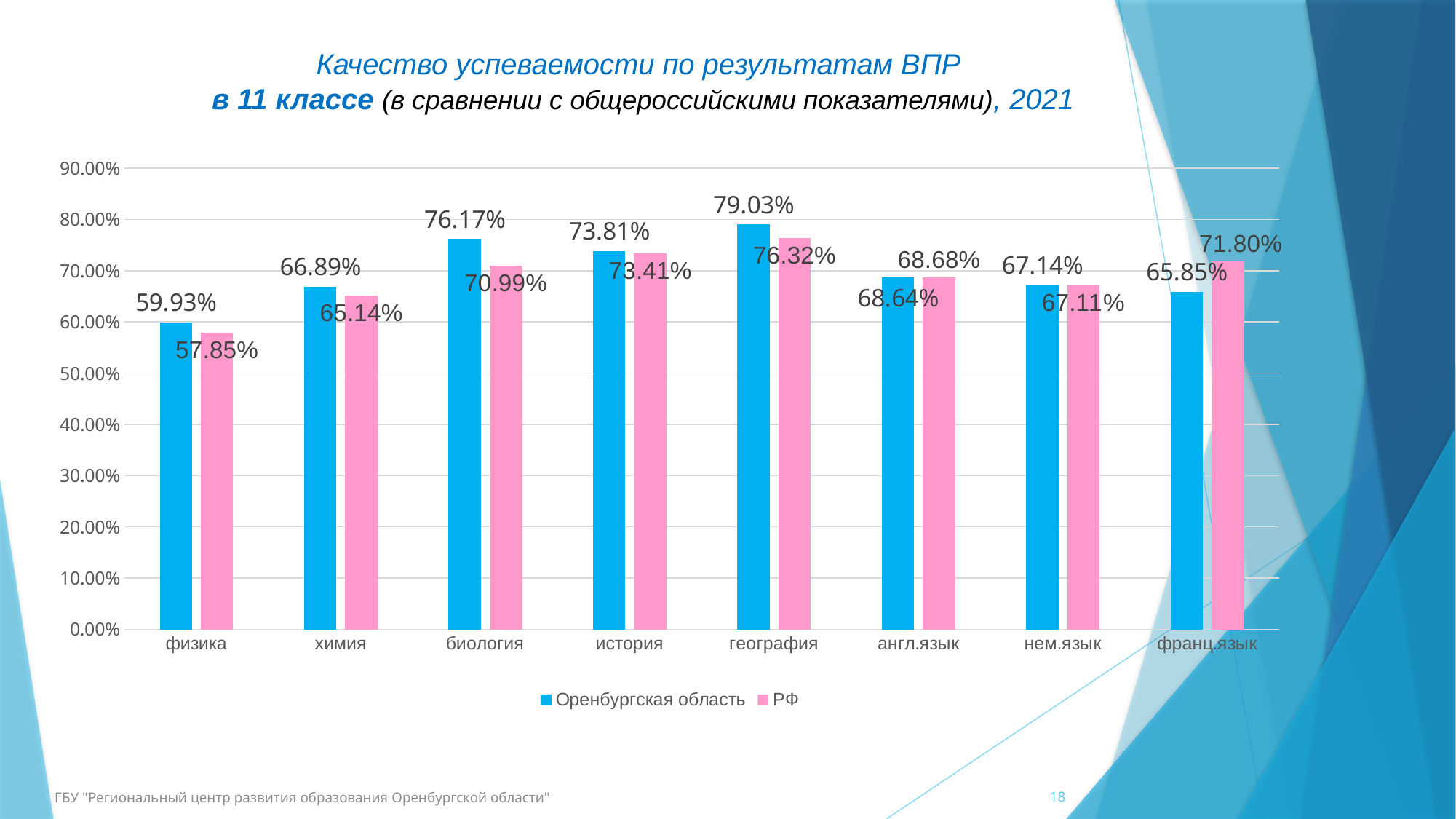
What is the value for РФ in физика? 57.85% For франц.язык, which is larger: Оренбургская область or РФ? РФ Which subject has the lowest value for РФ? физика For география, which is larger: Оренбургская область or РФ? Оренбургская область What is the value for Оренбургская область in биология? 76.17% What is the value for РФ in франц.язык? 71.80% Which subject has the highest value for Оренбургская область? география How many series does the legend list? 2 What is the difference between the Оренбургская область and РФ values for биология? 5.18% How many subjects are shown on the x axis? 8 What is the difference between the РФ and Оренбургская область values for франц.язык? 5.95% What kind of chart is shown on the slide? Bar chart